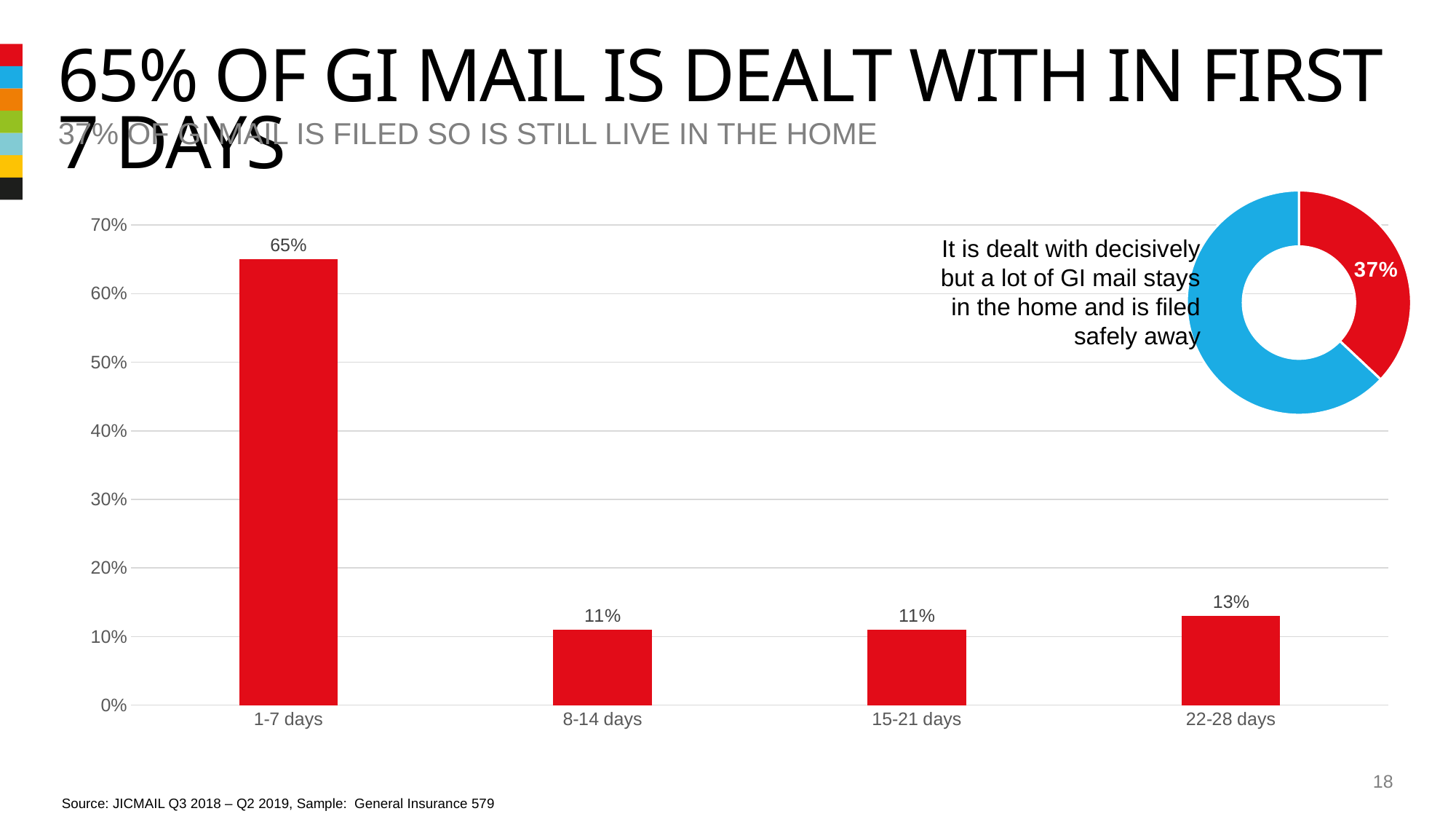
On the bar chart, what is the value for 22-28 days? 13% On the bar chart, which is larger, the value for 22-28 days or the value for 15-21 days? 22-28 days On the bar chart, which category has the highest value? 1-7 days On the bar chart, what is the value for 1-7 days? 65% On the doughnut chart in the top right, what value is printed on the red slice? 37% What kind of chart is the chart on the left of the slide? bar chart On the bar chart, what is the difference between the values for 1-7 days and 22-28 days? 52% On the bar chart, is the value for 1-7 days greater or less than 60%? greater On the bar chart, what is the value for 8-14 days? 11% How many categories are shown on the bar chart? 4 On the bar chart, what colour are the bars? red What kind of chart is the chart in the top right of the slide? doughnut chart